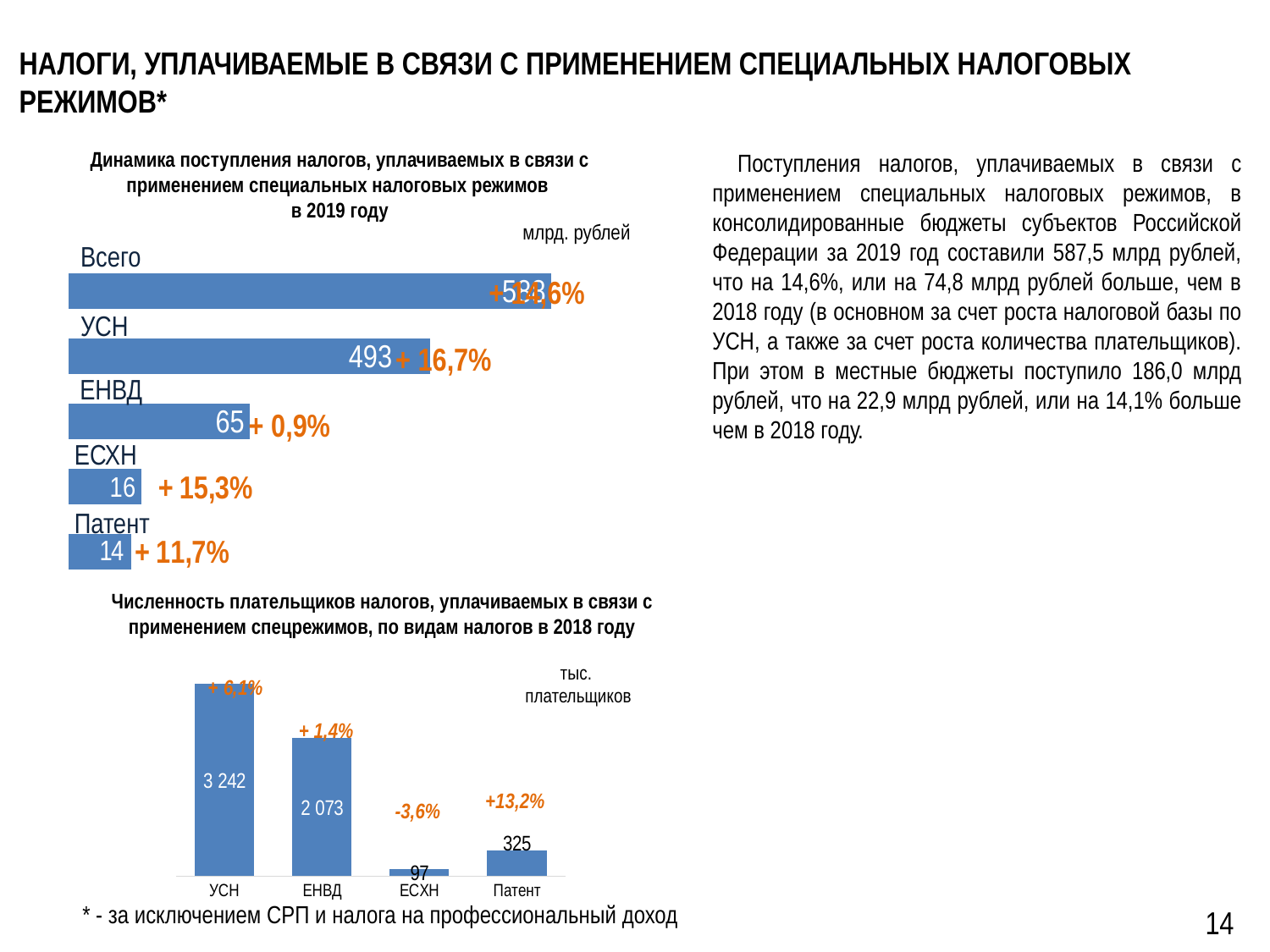
In the top chart (Динамика поступления налогов ... в 2019 году), what unit is stated for the values? млрд. рублей In the bottom chart (Численность плательщиков ... в 2018 году), what is the value for ЕСХН? 97 In the top chart (Динамика поступления налогов ... в 2019 году), which of the individual tax regimes (excluding Всего) has the highest value? УСН In the top chart (Динамика поступления налогов ... в 2019 году), what is the value for УСН? 493 In the bottom chart (Численность плательщиков ... в 2018 году), what is the value for УСН? 3 242 In the top chart (Динамика поступления налогов ... в 2019 году), what is the difference between the values for УСН and ЕНВД? 428 In the bottom chart (Численность плательщиков ... в 2018 году), what is the difference between the values for ЕНВД and Патент? 1 748 In the top chart (Динамика поступления налогов ... в 2019 году), what is the value for Патент? 14 In the bottom chart (Численность плательщиков ... в 2018 году), which category has the lowest value? ЕСХН In the top chart (Динамика поступления налогов ... в 2019 году), what percentage change is shown next to ЕСХН? + 15,3% In the bottom chart (Численность плательщиков ... в 2018 году), how many categories are shown? 4 In the top chart (Динамика поступления налогов ... в 2019 году), what is the value for ЕНВД? 65